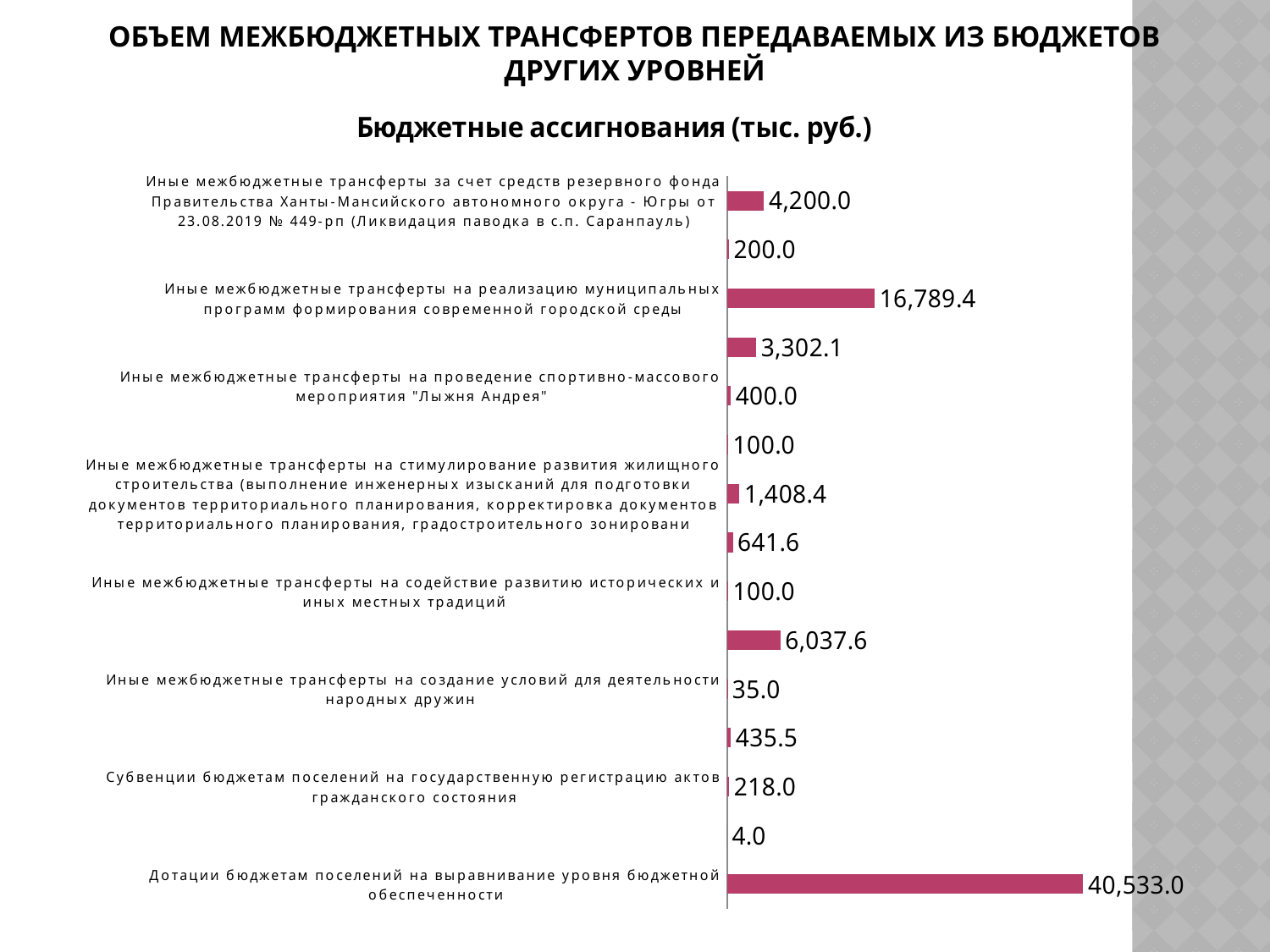
What is the smallest value labelled on the chart? 4.0 What is the difference between the value for 'Дотации бюджетам поселений на выравнивание уровня бюджетной обеспеченности' and the value for 'Иные межбюджетные трансферты на реализацию муниципальных программ формирования современной городской среды'? 23,743.6 What is the value for 'Дотации бюджетам поселений на выравнивание уровня бюджетной обеспеченности'? 40,533.0 What is the value for 'Субвенции бюджетам поселений на государственную регистрацию актов гражданского состояния'? 218.0 What is the value for 'Иные межбюджетные трансферты на проведение спортивно-массового мероприятия "Лыжня Андрея"'? 400.0 Which is larger: the value for 'Иные межбюджетные трансферты на реализацию муниципальных программ формирования современной городской среды' or the value for 'Иные межбюджетные трансферты на проведение спортивно-массового мероприятия "Лыжня Андрея"'? Иные межбюджетные трансферты на реализацию муниципальных программ формирования современной городской среды Which category has the highest value? Дотации бюджетам поселений на выравнивание уровня бюджетной обеспеченности What is the value for 'Иные межбюджетные трансферты на создание условий для деятельности народных дружин'? 35.0 What kind of chart is shown on the slide? bar chart What is the value for 'Иные межбюджетные трансферты на реализацию муниципальных программ формирования современной городской среды'? 16,789.4 What is the title of the chart? Бюджетные ассигнования (тыс. руб.) How many bars are plotted on the chart? 15